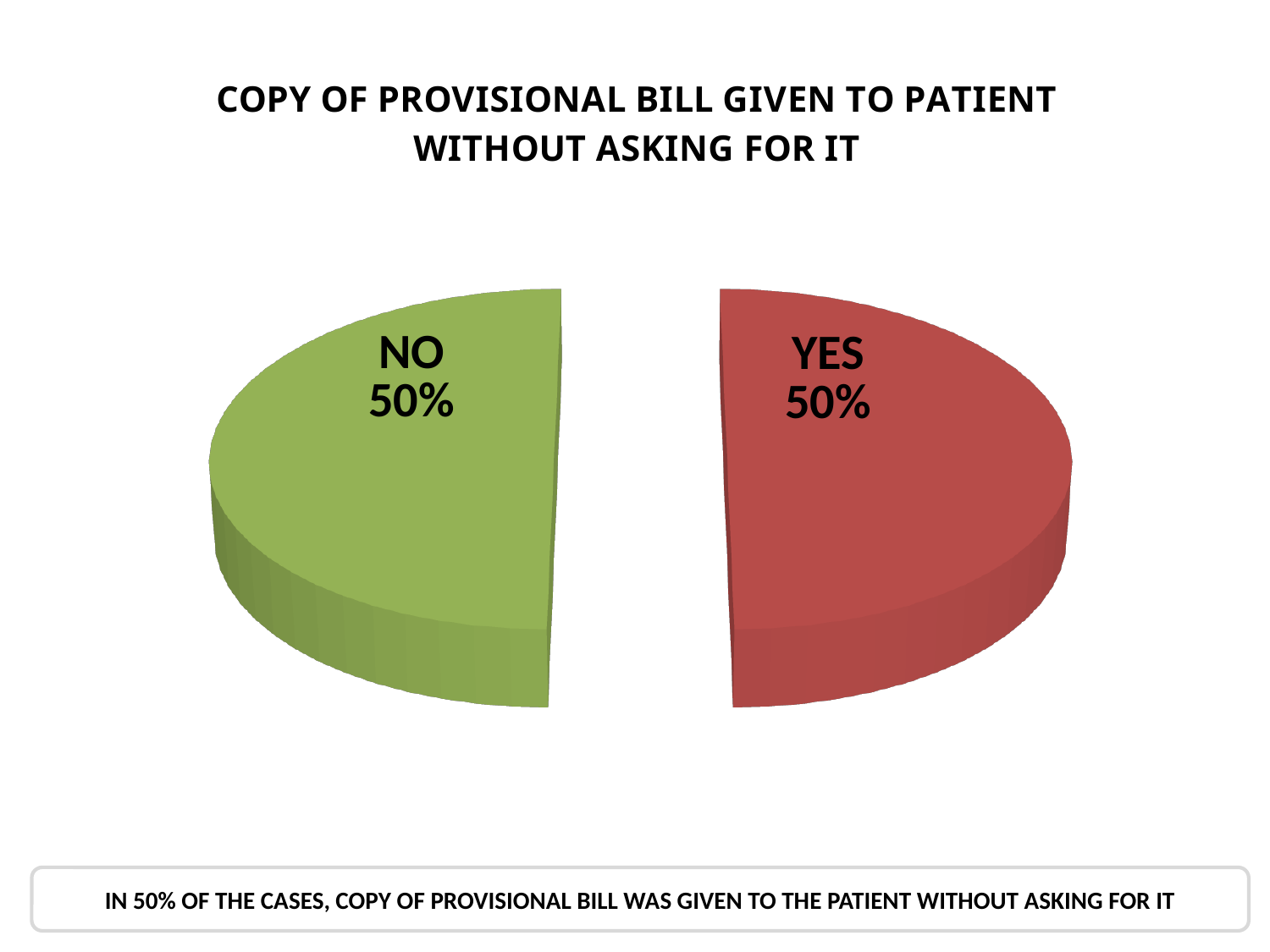
What percentage of cases is labelled YES? 50% What kind of chart is shown on the slide? pie chart What colour is the YES slice? red What percentage of cases is labelled NO? 50% What is the difference between the YES and NO percentages? 0% What share of the pie does the YES slice represent? 50% What is the combined total of the YES and NO slices? 100% What is the title of the chart? COPY OF PROVISIONAL BILL GIVEN TO PATIENT WITHOUT ASKING FOR IT How many slices does the pie chart have? 2